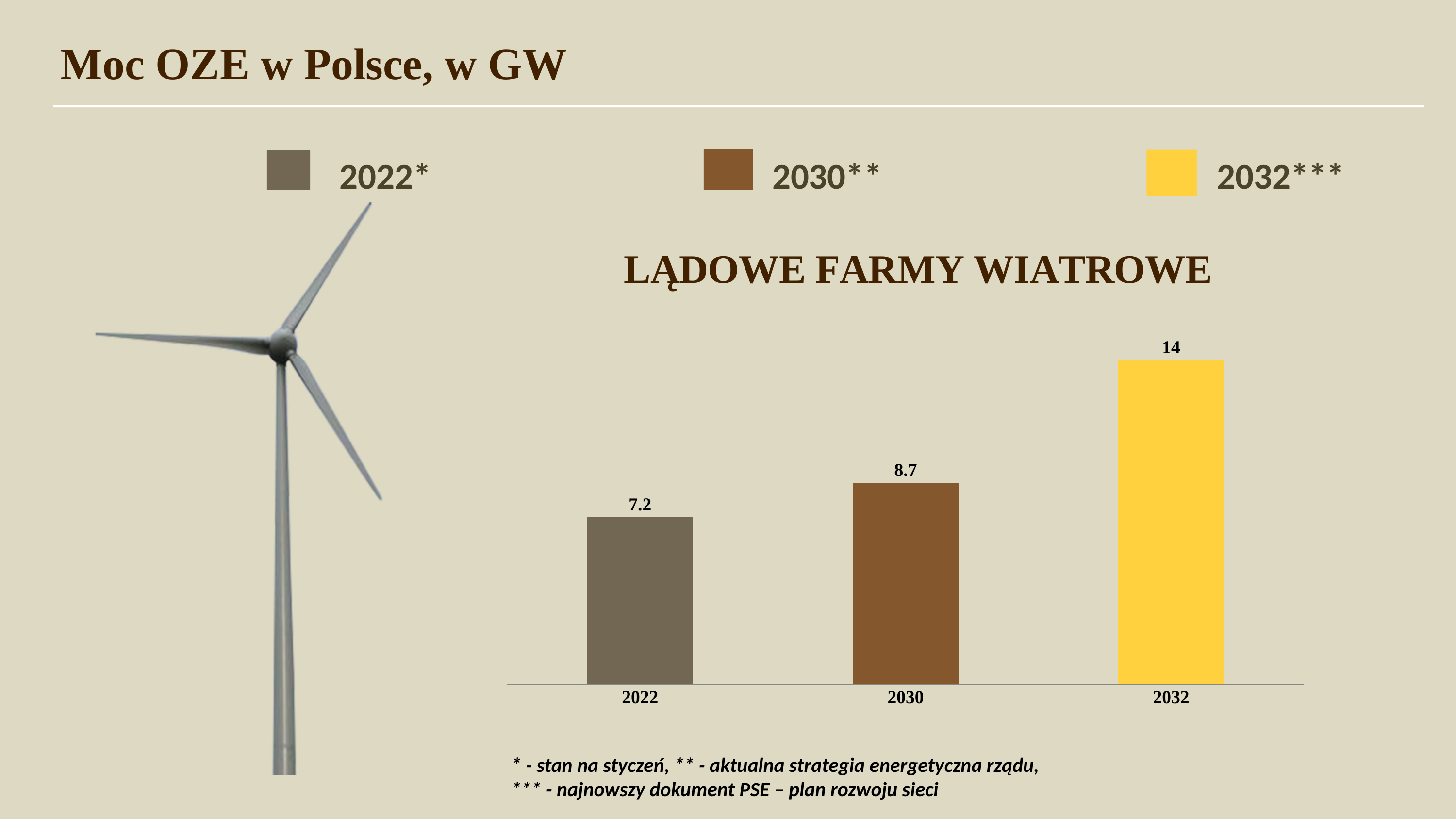
What colour is the bar for 2032? yellow Do the values rise or fall from 2022 to 2032? rise What is the value for 2030 in the LĄDOWE FARMY WIATROWE chart? 8.7 What is the value for 2022 in the LĄDOWE FARMY WIATROWE chart? 7.2 What is the difference between the values for 2032 and 2022? 6.8 What kind of chart is shown on the slide? bar chart Which year has the lowest value in the chart? 2022 What is the value for 2032 in the LĄDOWE FARMY WIATROWE chart? 14 What is the difference between the values for 2030 and 2022? 1.5 Which year has the highest value in the chart? 2032 How many bars are shown in the chart? 3 Which is larger, the value for 2030 or the value for 2032? 2032